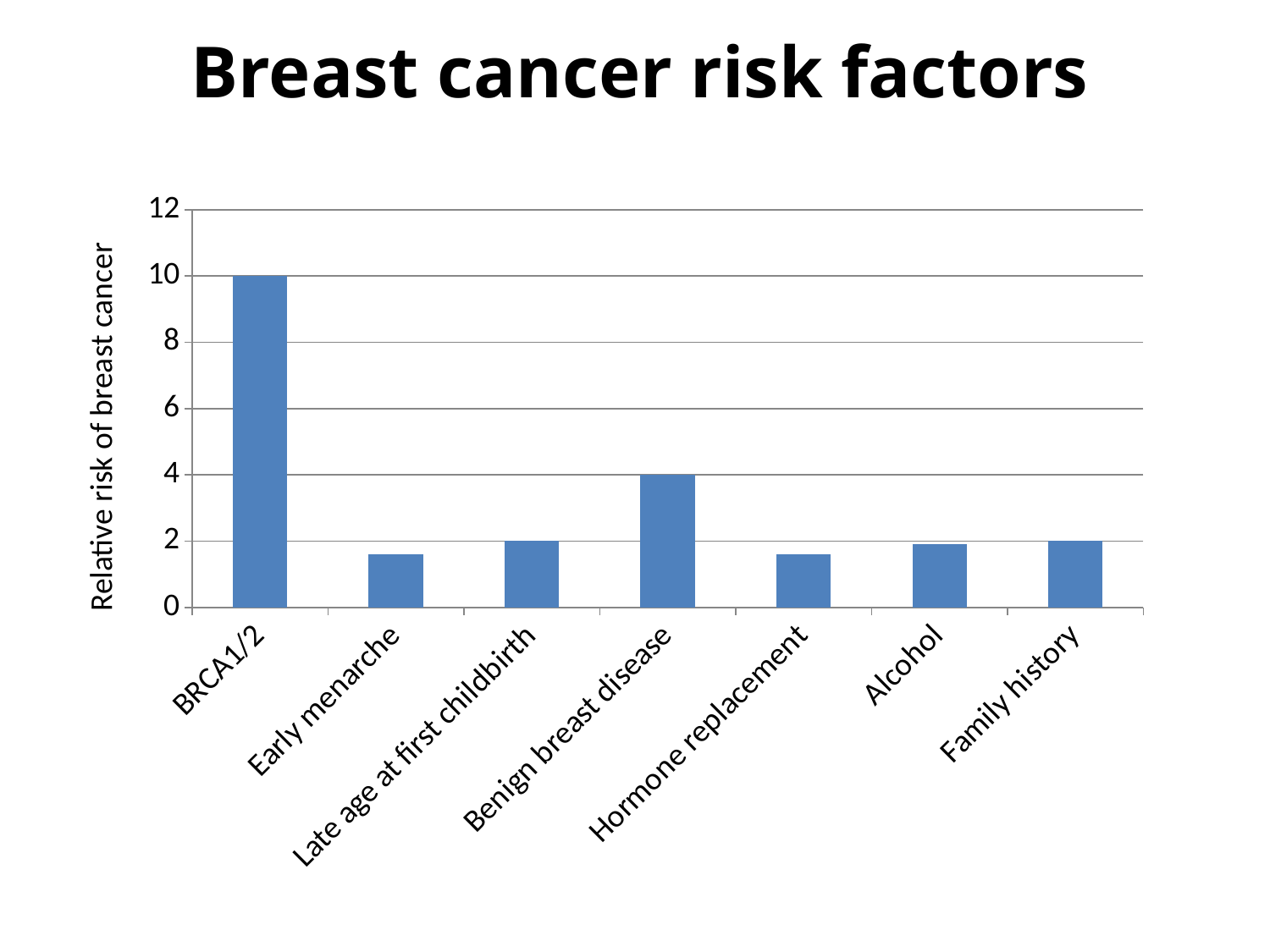
Which has a larger relative risk, Benign breast disease or Family history? Benign breast disease What is the label on the vertical axis of the chart? Relative risk of breast cancer What is the difference in relative risk between BRCA1/2 and Benign breast disease? 6 What is the relative risk of breast cancer for Late age at first childbirth? 2 How many risk factors (categories) are plotted on the chart? 7 Which risk factor has the highest relative risk of breast cancer? BRCA1/2 What is the relative risk of breast cancer for Family history? 2 Is the relative risk for Hormone replacement greater or less than 2? less What type of chart is shown on the slide? Bar chart Is the relative risk for Early menarche greater or less than 2? less What is the relative risk of breast cancer for Benign breast disease? 4 What is the relative risk of breast cancer for BRCA1/2? 10